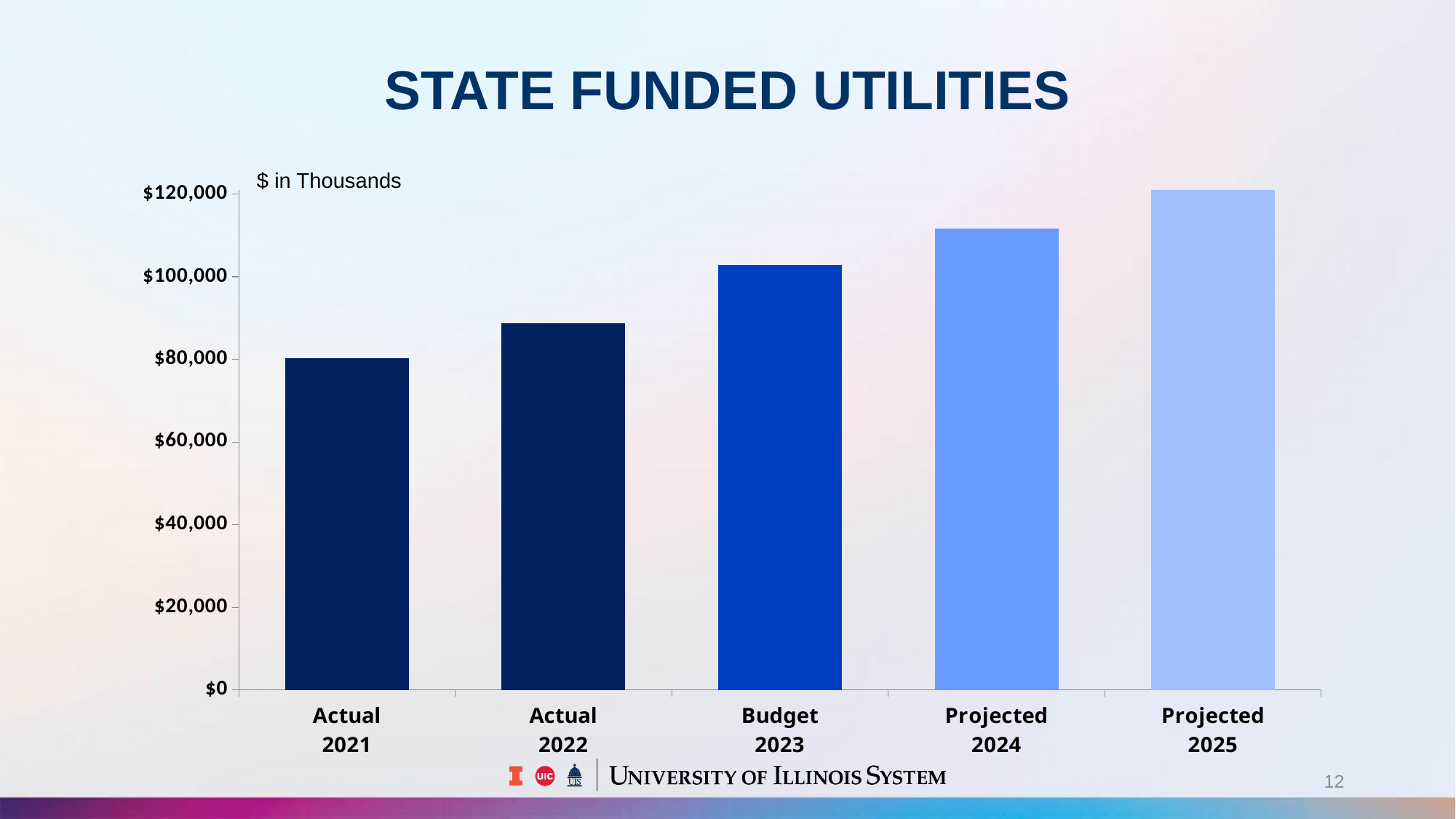
Is the value for Actual 2022 greater or less than $80,000? greater Which category has the highest value? Projected 2025 What kind of chart is shown on the slide? bar chart Which is larger, the value for Budget 2023 or the value for Projected 2024? Projected 2024 Is the value for Budget 2023 greater or less than $100,000? greater How many bars are plotted in the chart? 5 What is the title of the chart? STATE FUNDED UTILITIES Which category has the lowest value? Actual 2021 Is the value for Projected 2024 greater or less than $120,000? less Do the values rise or fall from Actual 2021 to Projected 2025? rise In what units are the values on the chart expressed? $ in Thousands